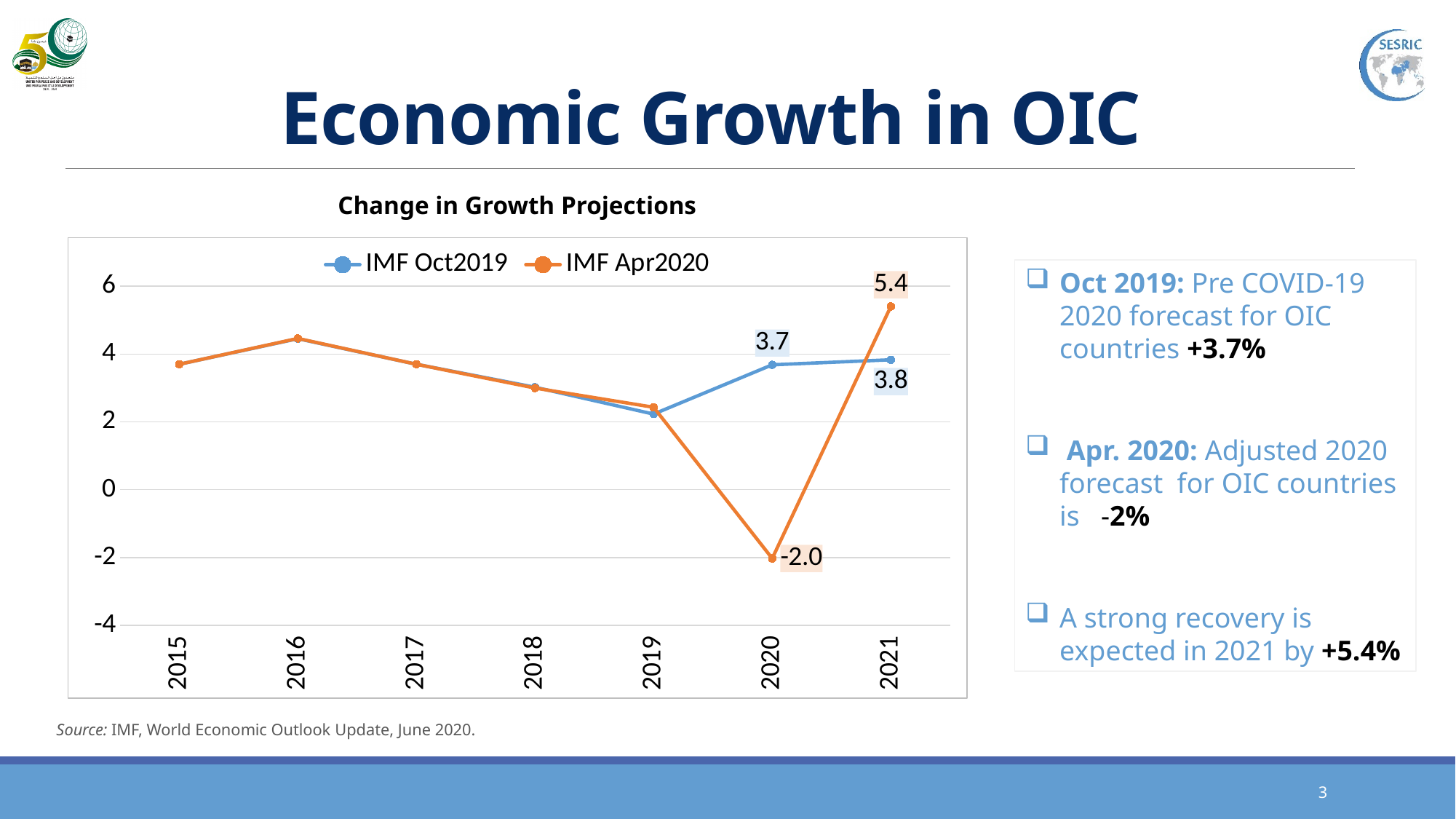
What is the IMF Oct2019 value for 2021? 3.8 How many years are shown on the x axis? 7 What is the difference between the IMF Oct2019 and IMF Apr2020 values for 2020? 5.7 What is the difference between the IMF Apr2020 and IMF Oct2019 values for 2021? 1.6 What is the IMF Apr2020 value for 2021? 5.4 What is the IMF Oct2019 value for 2020? 3.7 Which series has the higher value for 2021, IMF Oct2019 or IMF Apr2020? IMF Apr2020 In which year does the IMF Apr2020 series reach its lowest value? 2020 How many series does the legend list? 2 What kind of chart is shown on the slide? line chart What is the IMF Apr2020 value for 2020? -2.0 Is the IMF Apr2020 value for 2016 greater or less than 4? greater